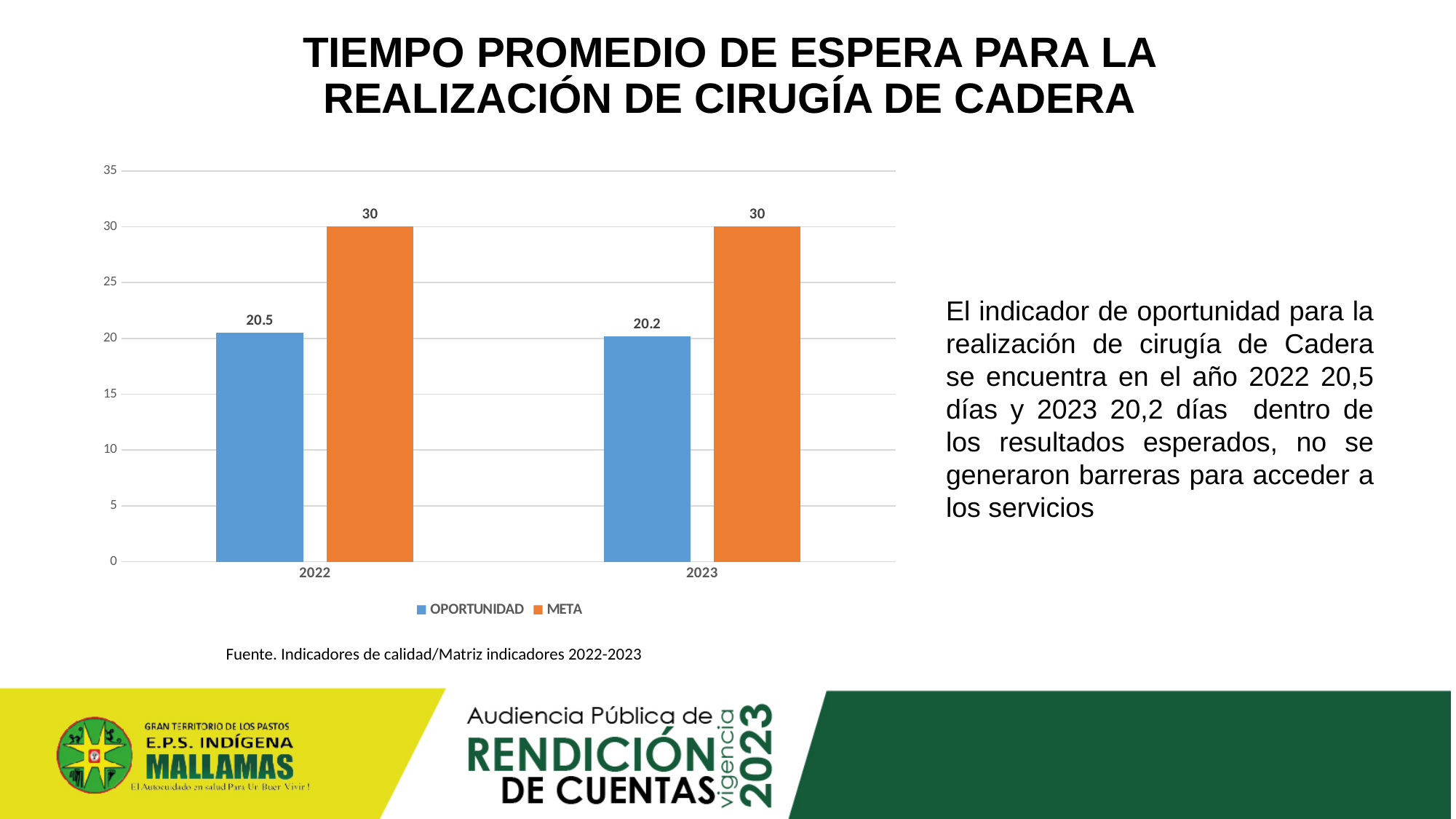
What is the META value for 2023? 30 Which year has the lower OPORTUNIDAD value? 2023 Is the OPORTUNIDAD value for 2023 greater or less than 25? less What kind of chart is shown on the slide? bar chart What is the difference between the META and OPORTUNIDAD values for 2022? 9.5 What is the META value for 2022? 30 How many years are shown on the x axis? 2 What is the OPORTUNIDAD value for 2022? 20.5 What is the difference between the OPORTUNIDAD values for 2022 and 2023? 0.3 How many series does the legend list? 2 Which year has the higher OPORTUNIDAD value? 2022 What is the OPORTUNIDAD value for 2023? 20.2